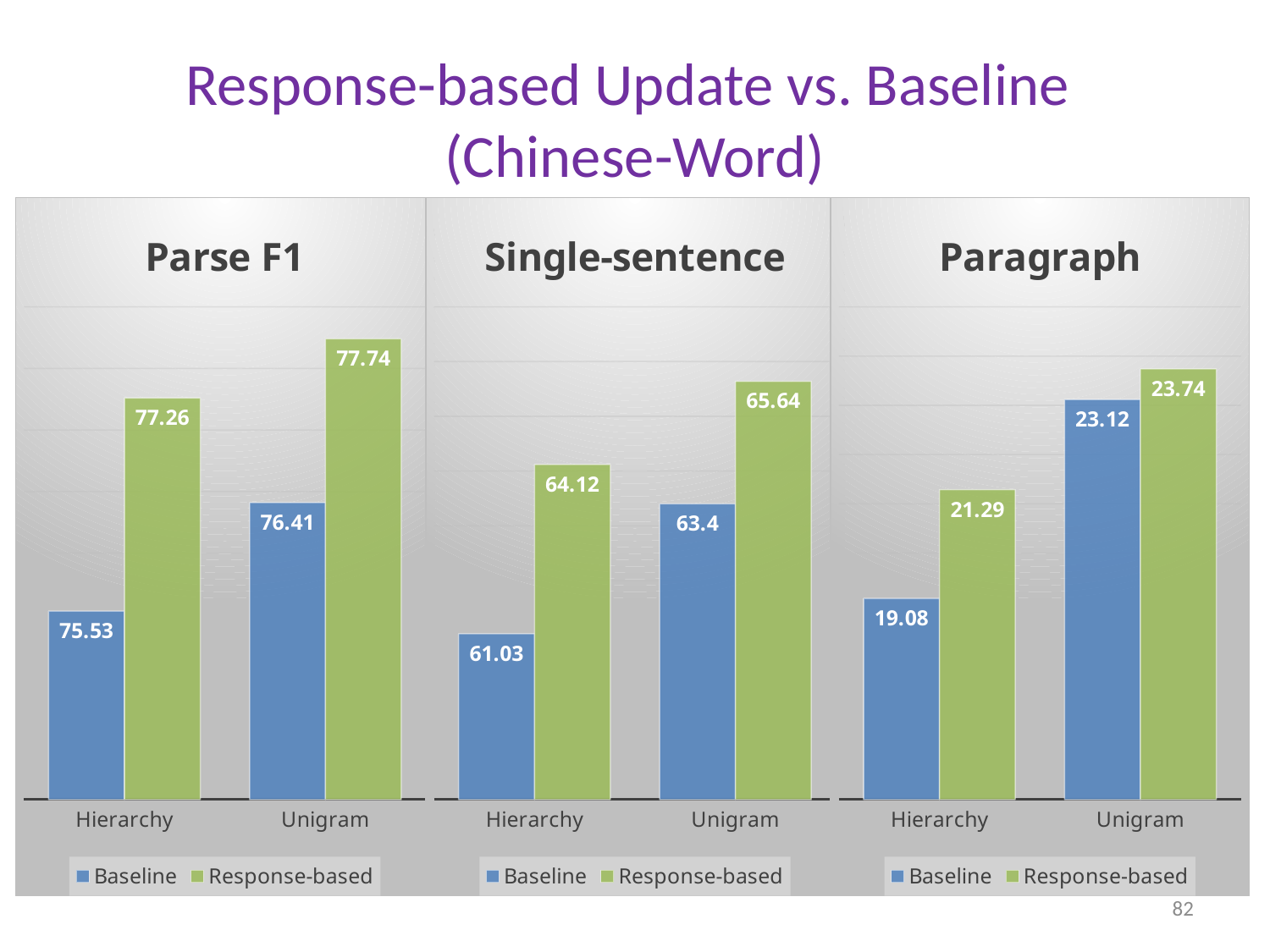
How many categories are shown on the x axis of the Paragraph chart? 2 What kind of chart is the Single-sentence chart? Bar chart In the Parse F1 chart, which bar has the lowest value? Baseline for Hierarchy In the Single-sentence chart, what is the difference between the Response-based and Baseline values for Unigram? 2.24 In the Paragraph chart, what is the difference between the Response-based and Baseline values for Hierarchy? 2.21 How many series does the legend of the Parse F1 chart list? 2 In the Paragraph chart, what is the Baseline value for Unigram? 23.12 In the Paragraph chart, which is larger: the Baseline value for Unigram or the Response-based value for Hierarchy? Baseline value for Unigram In the Parse F1 chart, what is the Baseline value for Hierarchy? 75.53 In the Single-sentence chart, what is the Response-based value for Hierarchy? 64.12 In the Parse F1 chart, what is the Response-based value for Unigram? 77.74 In the Single-sentence chart, which bar has the highest value? Response-based for Unigram